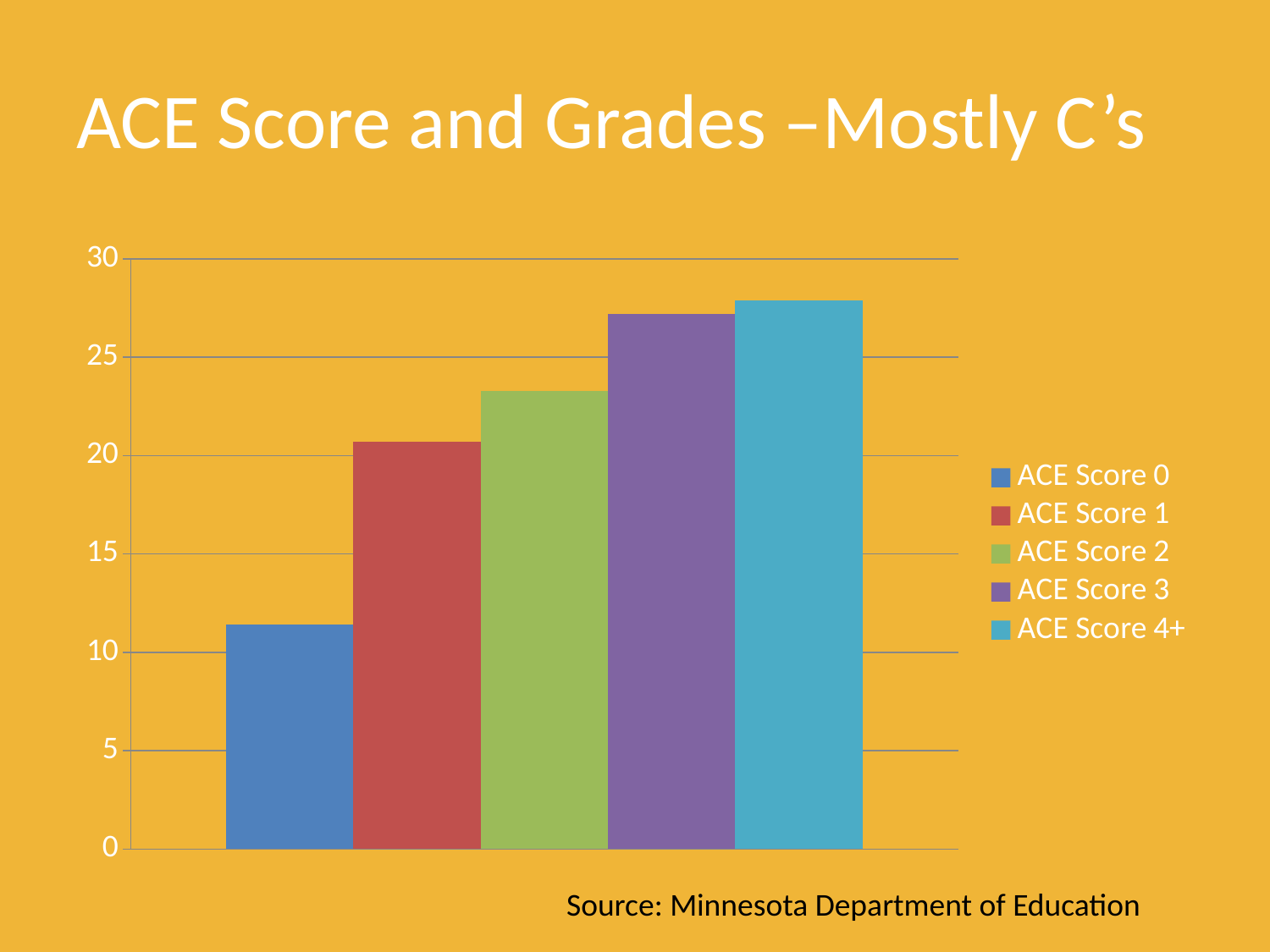
Is the value for ACE Score 4+ greater or less than 30? less Is the value for ACE Score 1 greater or less than 20? greater Which ACE Score group has the lowest value? ACE Score 0 What kind of chart is shown on the slide? bar chart Do the values rise or fall as the ACE Score increases from 0 to 4+? rise Is the value for ACE Score 0 greater or less than 15? less What is the title of the slide? ACE Score and Grades –Mostly C’s How many series does the legend list? 5 How many bars are plotted in the chart? 5 Which is larger, the value for ACE Score 0 or the value for ACE Score 1? ACE Score 1